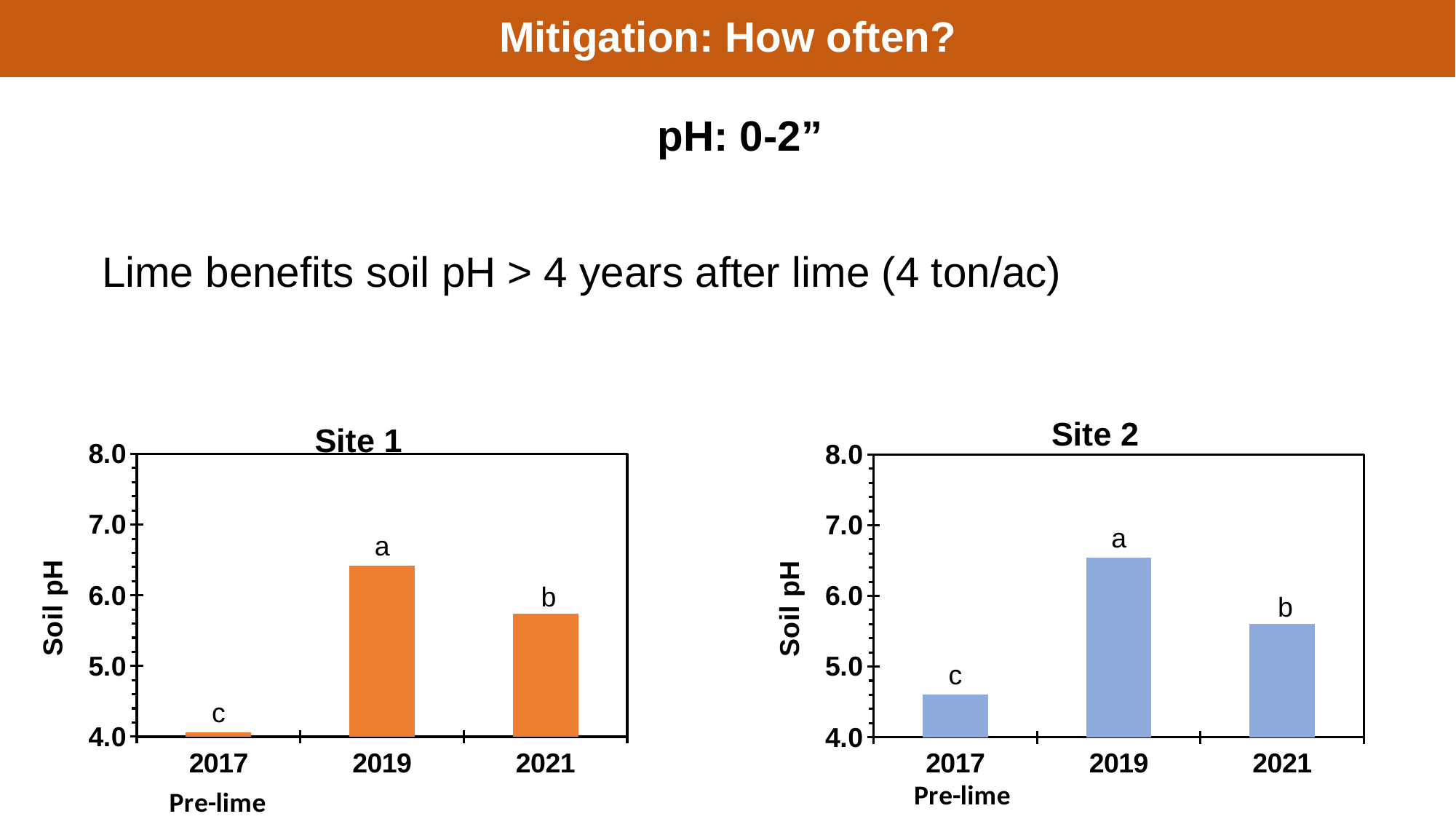
What is the title of the chart on the left side of the slide? Site 1 In the Site 1 chart, which year has the highest soil pH? 2019 In the Site 1 chart, which year has the lowest soil pH? 2017 In the Site 2 chart, which year has the lowest soil pH? 2017 In the Site 1 chart, is the soil pH for 2019 greater or less than 6.0? greater In the Site 2 chart, is the soil pH for 2021 greater or less than 5.0? greater How many bars are shown in the Site 2 chart? 3 What kind of chart is the Site 1 chart? bar chart What is the y-axis label on the Site 2 chart? Soil pH In the Site 1 chart, which year has a higher soil pH, 2019 or 2021? 2019 In the Site 2 chart, which year has the highest soil pH? 2019 In the Site 2 chart, is the soil pH for 2017 greater or less than 5.0? less